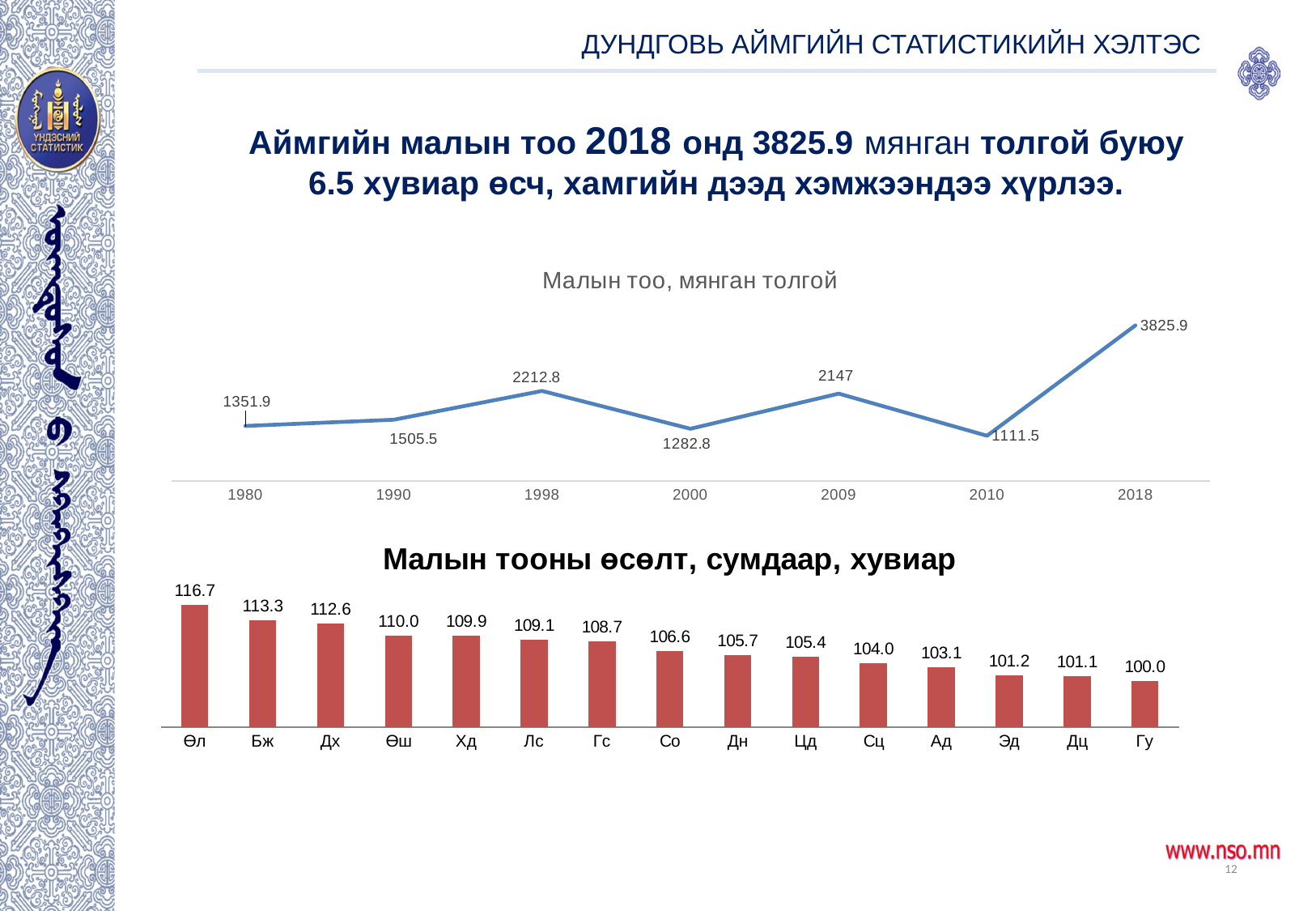
In the chart titled 'Малын тоо, мянган толгой', is the value for 2009 larger or smaller than the value for 2000? larger What kind of chart is the chart titled 'Малын тоо, мянган толгой'? line chart In the chart titled 'Малын тоо, мянган толгой', what is the value for 1998? 2212.8 In the chart titled 'Малын тоо, мянган толгой', what is the value for 2018? 3825.9 In the chart titled 'Малын тоо, мянган толгой', which year has the lowest value? 2010 What kind of chart is the chart titled 'Малын тооны өсөлт, сумдаар, хувиар'? bar chart In the chart titled 'Малын тооны өсөлт, сумдаар, хувиар', which category has the lowest value? Гу In the chart titled 'Малын тооны өсөлт, сумдаар, хувиар', what is the value for Со? 106.6 In the chart titled 'Малын тоо, мянган толгой', how many years are plotted? 7 In the chart titled 'Малын тооны өсөлт, сумдаар, хувиар', how many categories are shown? 15 In the chart titled 'Малын тооны өсөлт, сумдаар, хувиар', which category has the highest value? Өл In the chart titled 'Малын тоо, мянган толгой', what is the difference between the 2018 value and the 2010 value? 2714.4